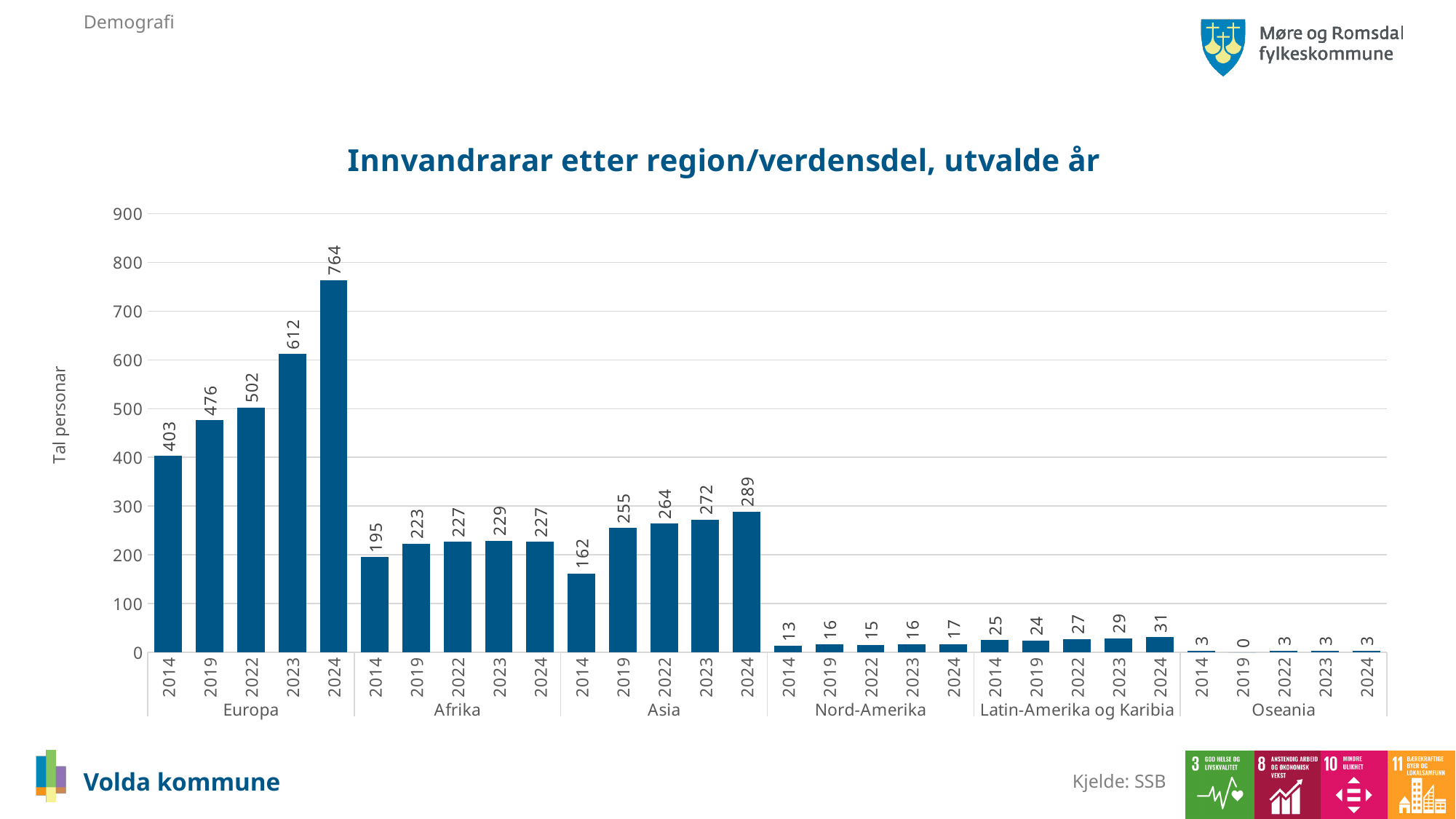
What is the value for Nord-Amerika in 2024? 17 What is the value for Oseania in 2019? 0 Do the values for Asia rise or fall from 2014 to 2024? rise Which region has the highest bar on the chart? Europa What is the difference between the Europa values for 2024 and 2014? 361 What kind of chart is this? bar chart What is the title of the chart? Innvandrarar etter region/verdensdel, utvalde år How many regions are shown on the x axis? 6 What is the value for Afrika in 2014? 195 What is the value for Europa in 2024? 764 Which is larger: Asia in 2024 or Afrika in 2024? Asia in 2024 What is the value for Asia in 2019? 255